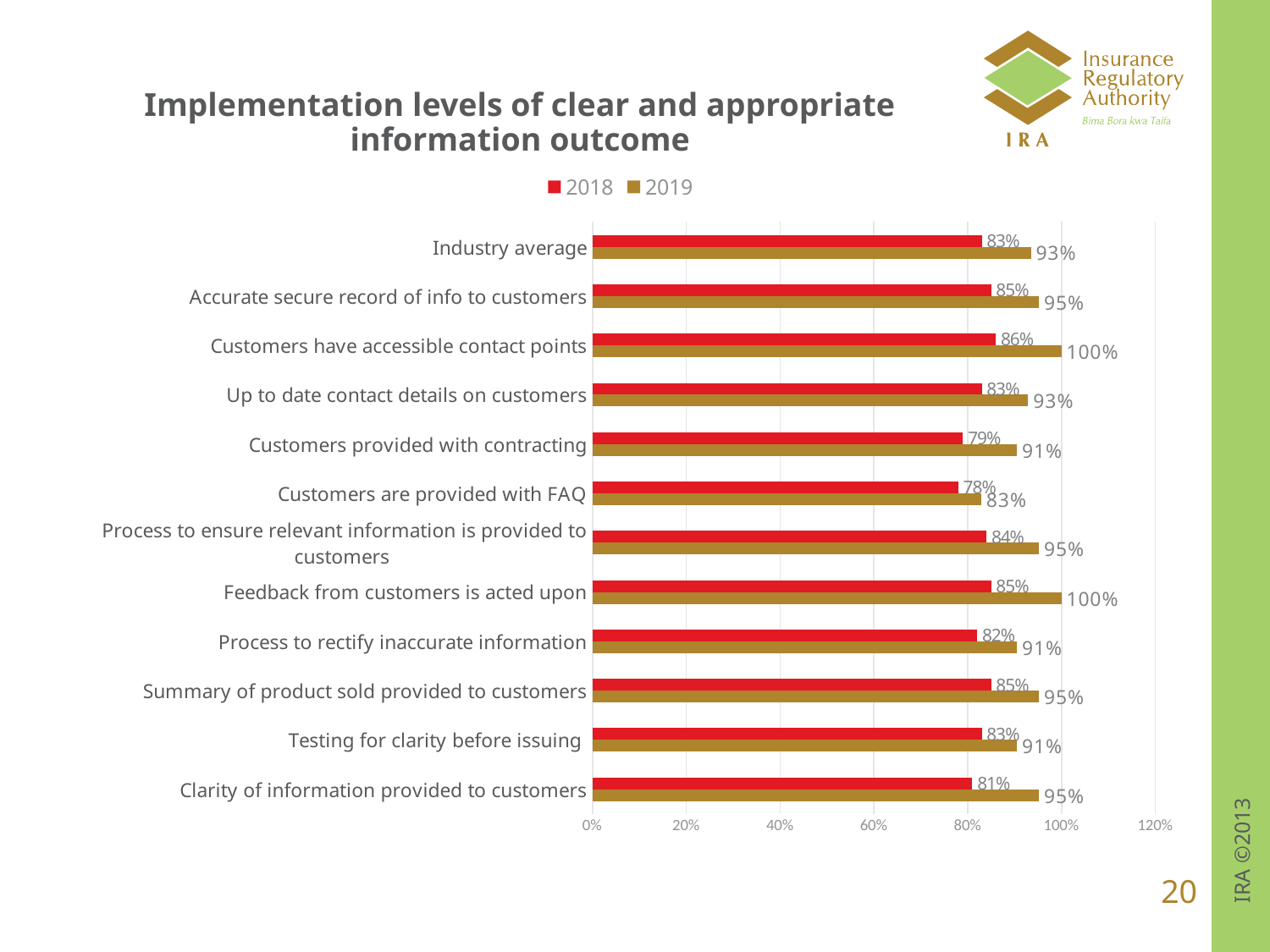
What is the 2018 value for Clarity of information provided to customers? 81% How many categories are shown on the chart? 12 Which category has the highest 2018 value? Customers have accessible contact points What is the difference between the 2019 and 2018 values for Clarity of information provided to customers? 14% What is the 2019 value for Customers have accessible contact points? 100% Which is larger: the 2019 value for Customers provided with contracting or the 2019 value for Customers are provided with FAQ? Customers provided with contracting Which colour represents the 2019 series? Gold What is the 2019 value for Industry average? 93% How many series does the legend list? 2 Which category has the lowest 2019 value? Customers are provided with FAQ What kind of chart is shown on the slide? Bar chart What is the 2018 value for Customers are provided with FAQ? 78%